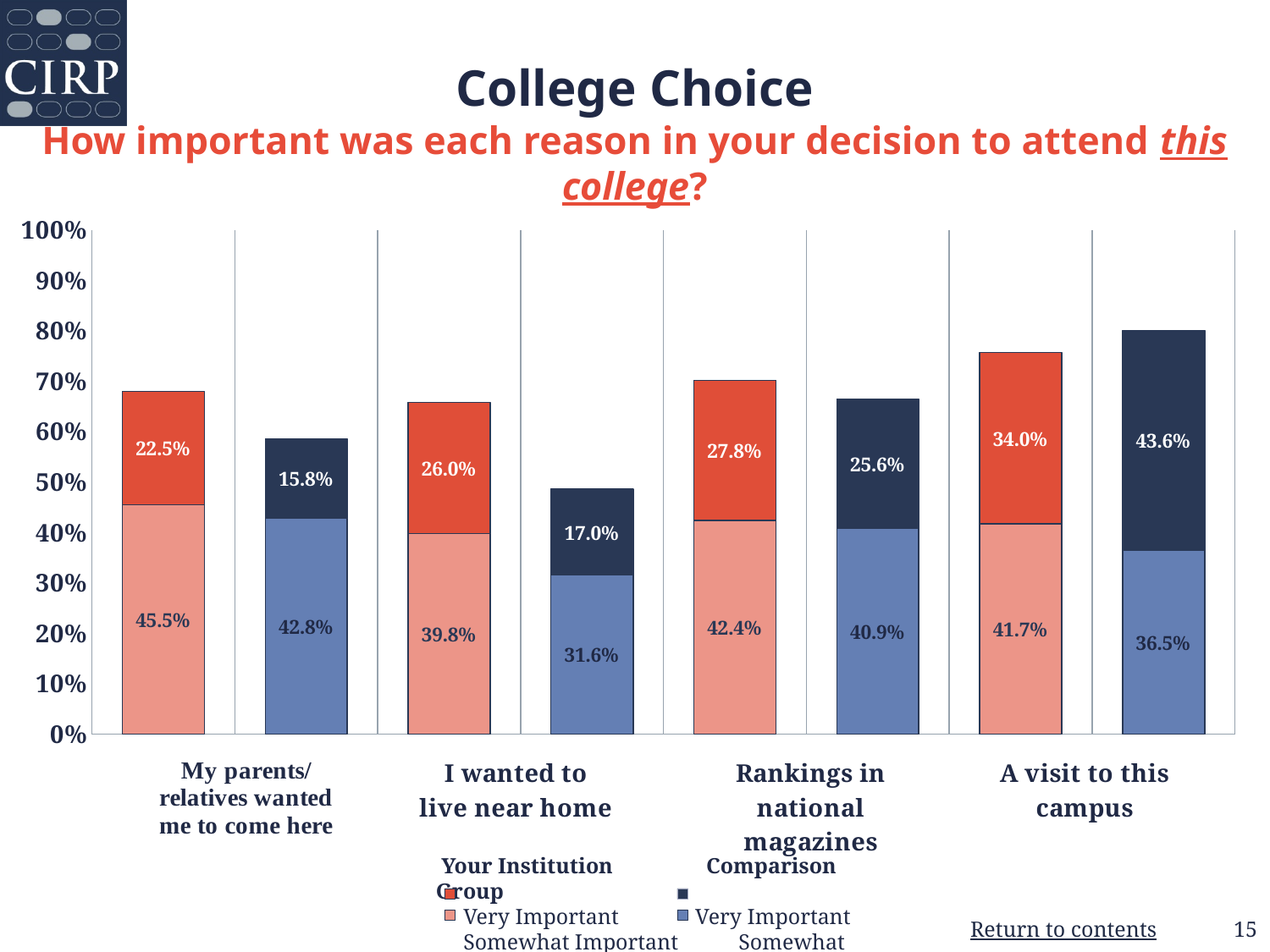
Is the total stacked bar for the Comparison Group on "I wanted to live near home" greater or less than 50%? less What type of chart is shown on the slide? Stacked bar chart What is the combined Very Important and Somewhat Important total for Your Institution on "Rankings in national magazines"? 70.2% What is the Very Important percentage for the Comparison Group on "Rankings in national magazines"? 25.6% What percentage of Your Institution respondents rated "A visit to this campus" as Very Important? 34.0% How many reasons (categories) are shown on the x axis of the chart? 4 For "A visit to this campus", which group has the larger Very Important percentage, Your Institution or the Comparison Group? Comparison Group Which reason has the lowest Very Important percentage for Your Institution? My parents/relatives wanted me to come here What is the Somewhat Important percentage for Your Institution on "My parents/relatives wanted me to come here"? 45.5% Which reason has the highest Very Important percentage for the Comparison Group? A visit to this campus What percentage of Comparison Group respondents rated "I wanted to live near home" as Somewhat Important? 31.6% What is the difference between the Very Important percentages for Your Institution and the Comparison Group on "I wanted to live near home"? 9.0%